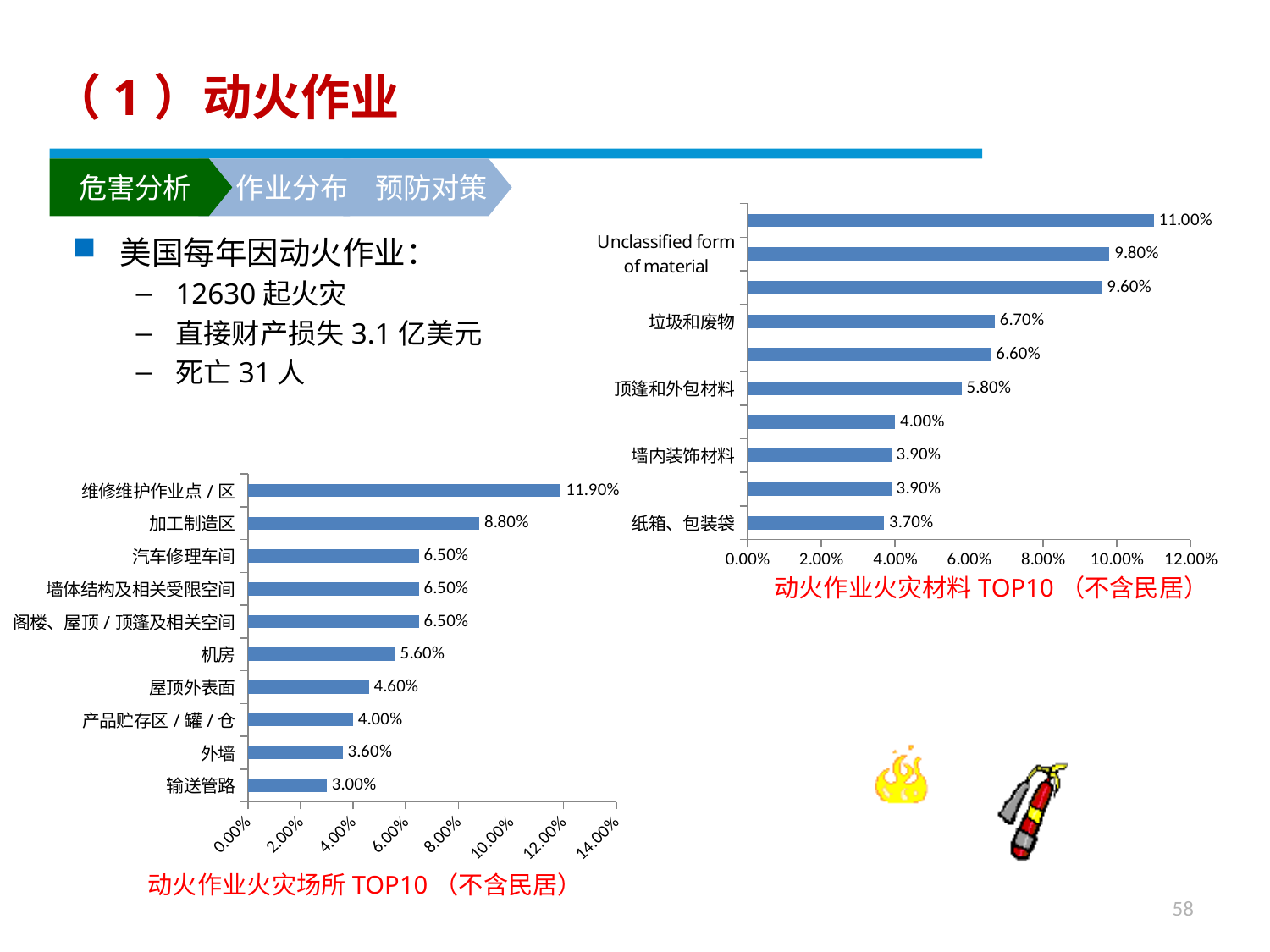
In the chart titled 动火作业火灾场所 TOP10（不含民居）, which category has the highest value? 维修维护作业点/区 In the chart titled 动火作业火灾材料 TOP10（不含民居）, what is the value for 纸箱、包装袋? 3.70% How many bars are shown in the chart titled 动火作业火灾材料 TOP10（不含民居）? 10 In the chart titled 动火作业火灾场所 TOP10（不含民居）, which is larger: 屋顶外表面 or 产品贮存区/罐/仓? 屋顶外表面 In the chart titled 动火作业火灾场所 TOP10（不含民居）, which category has the lowest value? 输送管路 In the chart titled 动火作业火灾场所 TOP10（不含民居）, what is the value for 机房? 5.60% In the chart titled 动火作业火灾场所 TOP10（不含民居）, what is the difference between 加工制造区 and 外墙? 5.20% In the chart titled 动火作业火灾场所 TOP10（不含民居）, what is the value for 维修维护作业点/区? 11.90% In the chart titled 动火作业火灾材料 TOP10（不含民居）, what is the difference between Unclassified form of material and 顶篷和外包材料? 4.00% How many categories are shown in the chart titled 动火作业火灾场所 TOP10（不含民居）? 10 What kind of chart is the chart titled 动火作业火灾材料 TOP10（不含民居）? Bar chart In the chart titled 动火作业火灾材料 TOP10（不含民居）, what is the value for 垃圾和废物? 6.70%